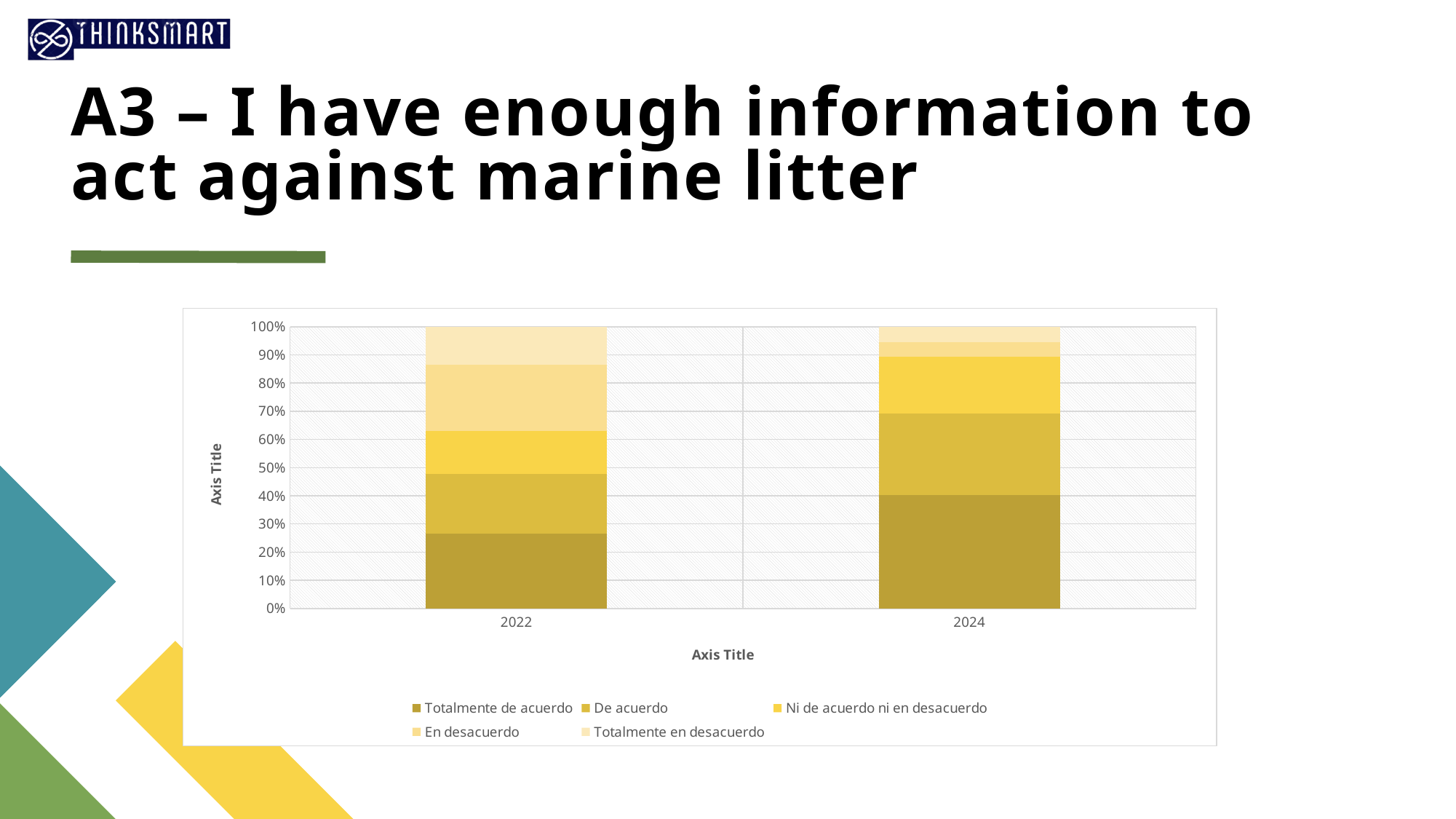
How many categories are shown on the x axis of the chart? 2 Which year has the larger 'Totalmente en desacuerdo' segment, 2022 or 2024? 2022 Is the 'Totalmente de acuerdo' segment for 2022 greater or less than 30%? less Does the 'En desacuerdo' share rise or fall from 2022 to 2024? fall What value does the top of each stacked bar reach on the y axis? 100% Which series forms the largest segment of the 2024 bar? Totalmente de acuerdo Which year has the larger 'Totalmente de acuerdo' segment, 2022 or 2024? 2024 What are the two categories on the x axis? 2022 and 2024 Does the 'Totalmente de acuerdo' share rise or fall from 2022 to 2024? rise Is the 'Totalmente de acuerdo' segment for 2024 greater or less than 30%? greater How many series does the chart legend list? 5 What kind of chart is shown on the slide? Stacked bar chart